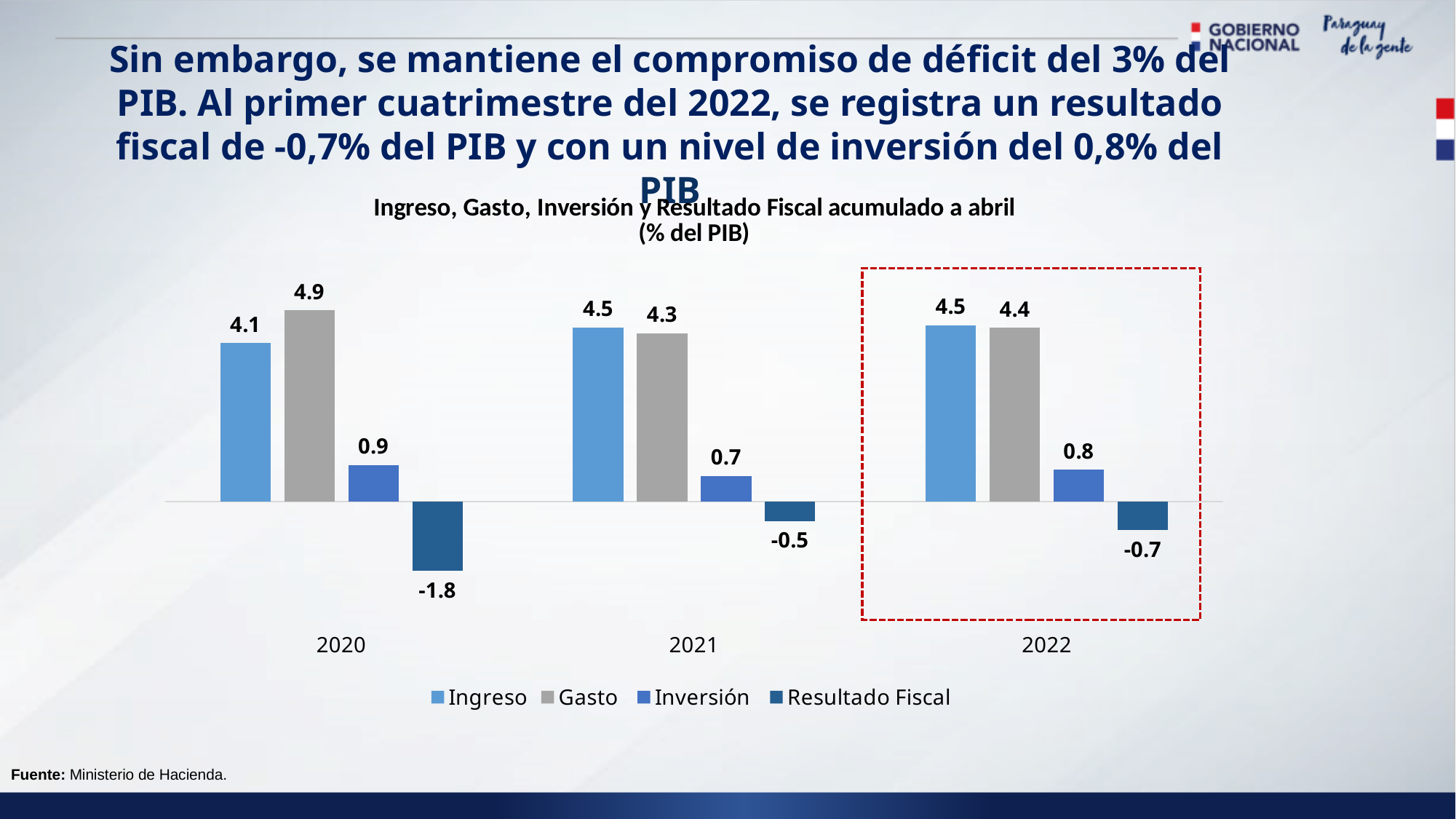
Does Inversión rise or fall from 2020 to 2021? Fall What kind of chart is shown on the slide? Bar chart In which year is Gasto highest? 2020 How many years are shown on the x axis? 3 How many series does the legend list? 4 Which is larger in 2022, Ingreso or Gasto? Ingreso What is the value of Gasto for 2021? 4.3 What is the value of Ingreso for 2020? 4.1 What is the value of Inversión for 2020? 0.9 What is the difference between Gasto and Ingreso in 2020? 0.8 What is the value of Resultado Fiscal for 2022? -0.7 In which year is Resultado Fiscal lowest? 2020